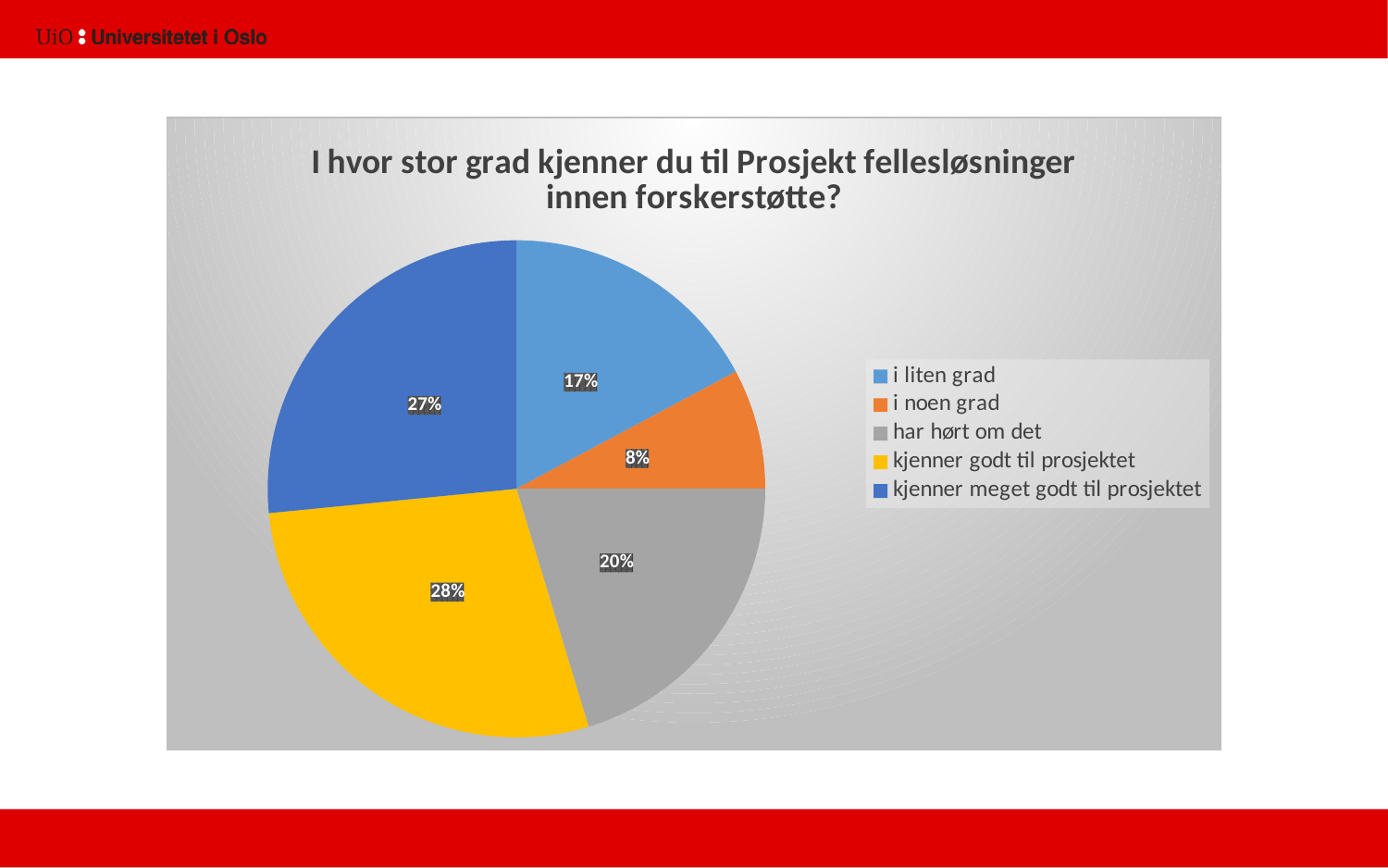
What percentage of respondents answered "kjenner meget godt til prosjektet"? 27% Which response category has the largest share of the pie? kjenner godt til prosjektet What is the title of the chart? I hvor stor grad kjenner du til Prosjekt fellesløsninger innen forskerstøtte? How many categories does the legend list? 5 What percentage of respondents answered "i liten grad"? 17% Which response category has the smallest share of the pie? i noen grad What percentage of respondents answered "i noen grad"? 8% What kind of chart is shown on the slide? pie chart What percentage of respondents answered "kjenner godt til prosjektet"? 28% What percentage of respondents answered "har hørt om det"? 20% Which is larger: the share for "i liten grad" or the share for "har hørt om det"? har hørt om det What is the difference in percentage points between "har hørt om det" and "i noen grad"? 12